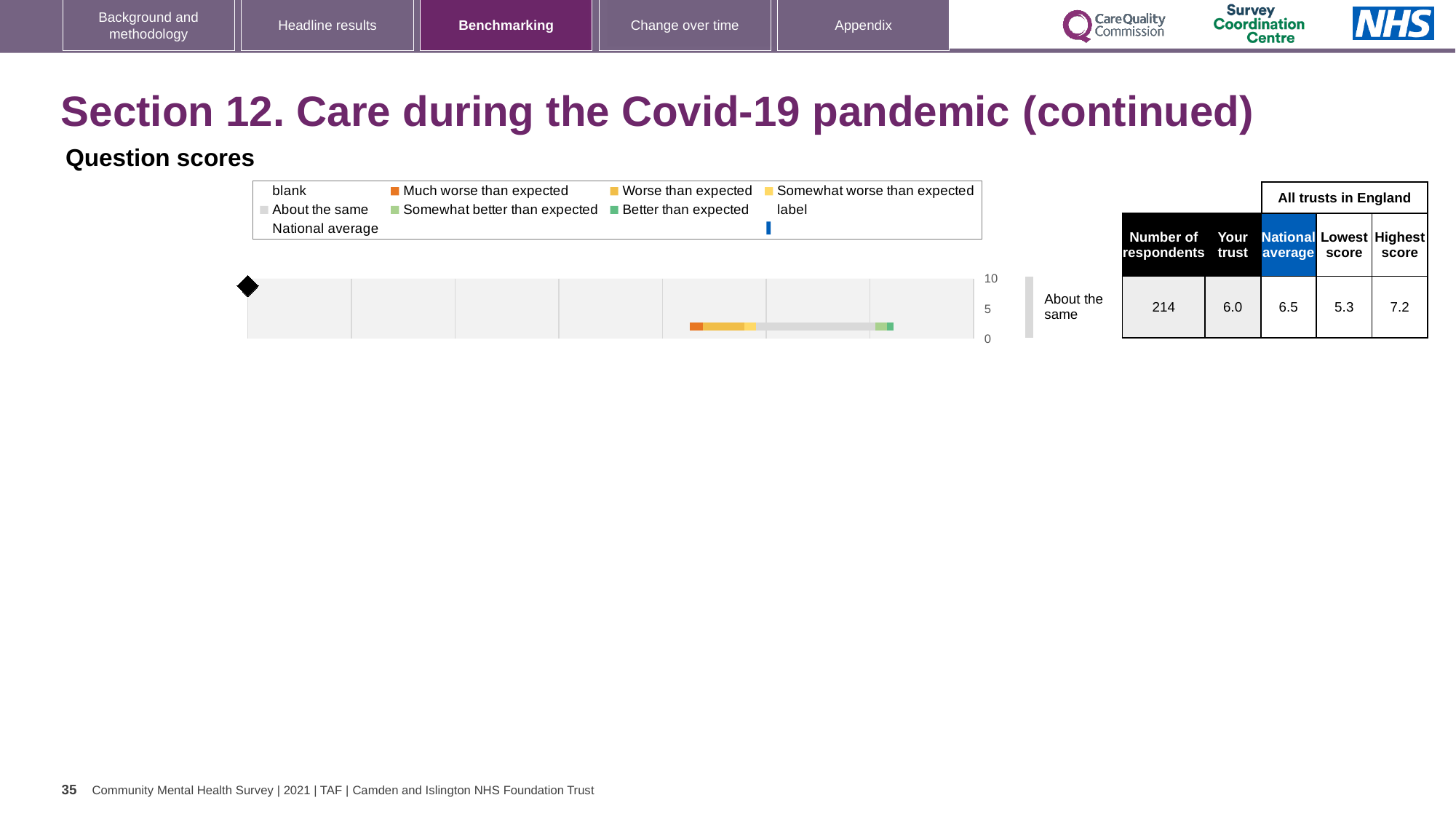
What is the highest score among all trusts in England shown in the table? 7.2 What is the difference between the national average and the 'Your trust' score? 0.5 What is the national average score shown in the table beside the chart? 6.5 How many respondents are shown in the table beside the chart? 214 Which benchmark category is the trust's score placed in, according to the label next to the chart? About the same What is the lowest score among all trusts in England shown in the table? 5.3 What kind of chart is shown under 'Question scores'? bar chart What is the difference between the highest score and the lowest score among all trusts in England? 1.9 What is the 'Your trust' score shown in the table beside the chart? 6.0 Which is larger, the 'Your trust' score or the national average? National average Which legend entry is shown with an orange colour? Much worse than expected What is the highest value shown on the chart's axis? 10